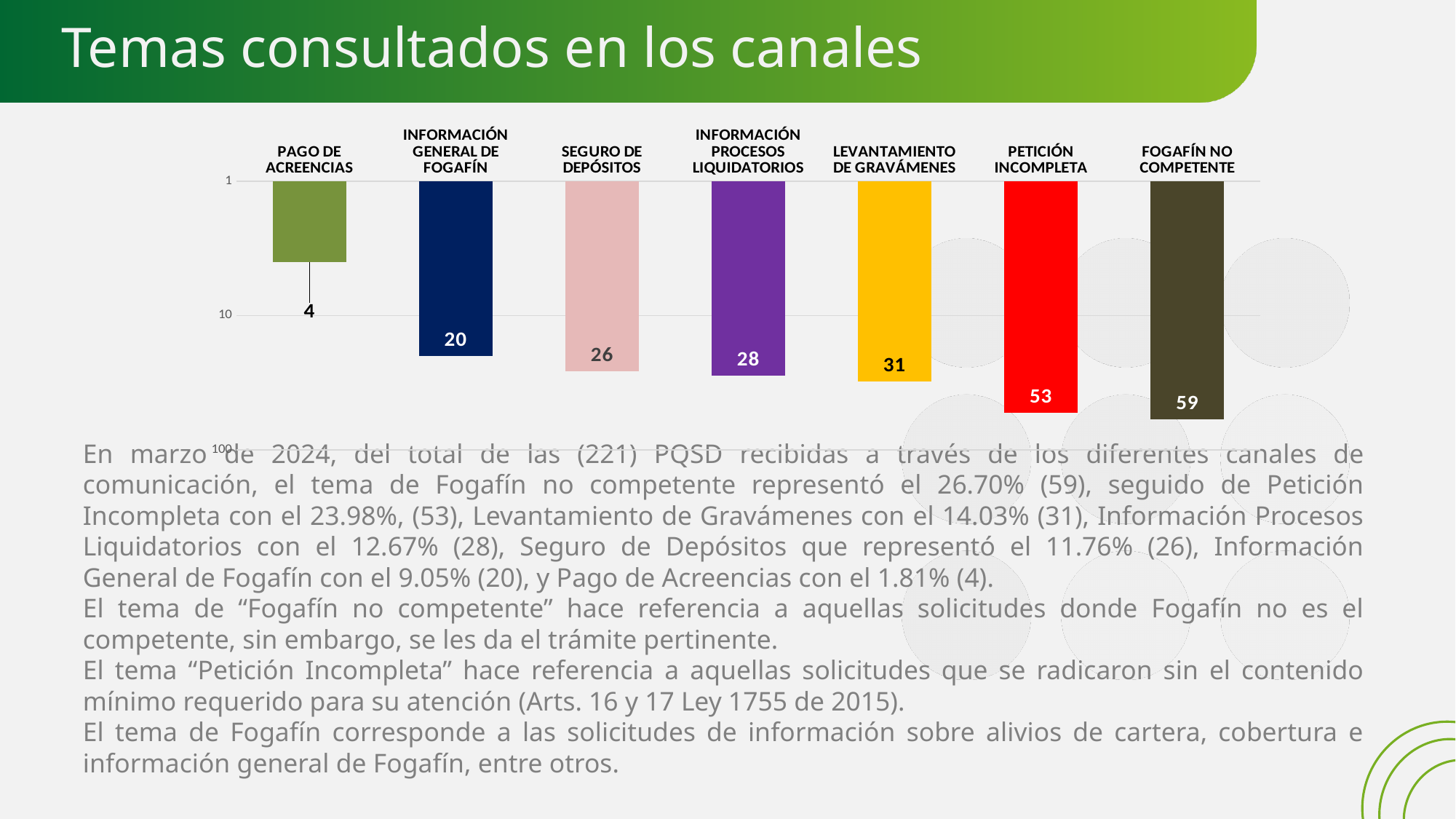
What colour is the bar for PETICIÓN INCOMPLETA? red What is the difference between the values for LEVANTAMIENTO DE GRAVÁMENES and PAGO DE ACREENCIAS? 27 Which is larger, the value for INFORMACIÓN PROCESOS LIQUIDATORIOS or the value for SEGURO DE DEPÓSITOS? INFORMACIÓN PROCESOS LIQUIDATORIOS Which category has the highest value? FOGAFÍN NO COMPETENTE Which category has the lowest value? PAGO DE ACREENCIAS What is the value for PETICIÓN INCOMPLETA? 53 What is the value for SEGURO DE DEPÓSITOS? 26 What is the difference between the values for FOGAFÍN NO COMPETENTE and PETICIÓN INCOMPLETA? 6 How many categories are shown in the chart? 7 Do the values rise or fall from left to right across the categories? rise What kind of chart is shown on the slide? bar chart What is the value for INFORMACIÓN GENERAL DE FOGAFÍN? 20